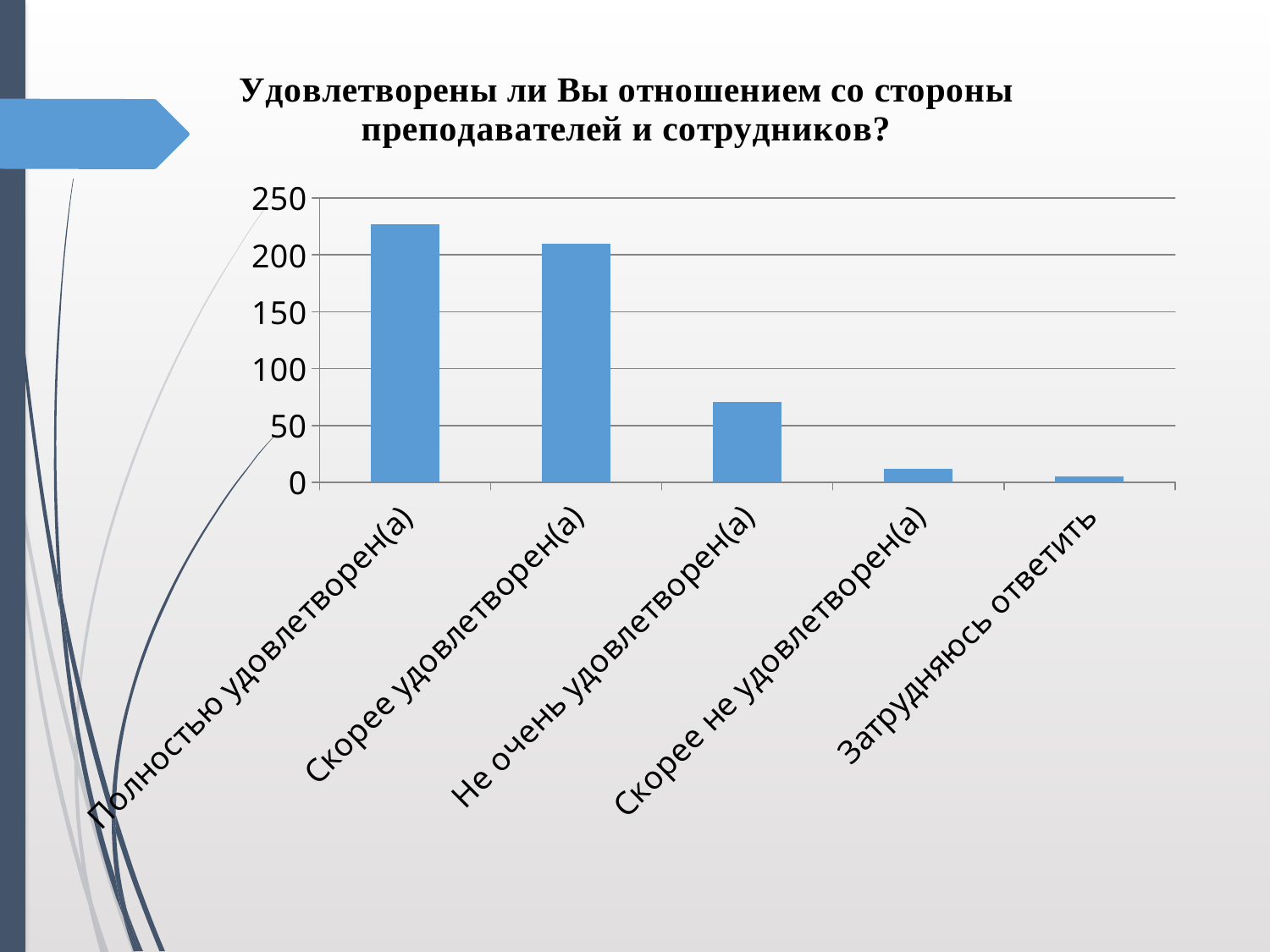
Which category has the lowest value? Затрудняюсь ответить Which category has the highest value? Полностью удовлетворен(а) Is the value for Не очень удовлетворен(а) greater or less than 100? less How many categories are shown on the x axis of the chart? 5 What kind of chart is shown on the slide? bar chart Do the values rise or fall moving from left to right along the x axis? fall Is the value for Полностью удовлетворен(а) greater or less than 200? greater What is the title of the chart? Удовлетворены ли Вы отношением со стороны преподавателей и сотрудников? Is the value for Скорее удовлетворен(а) greater or less than 250? less Which is larger, the value for Скорее удовлетворен(а) or the value for Не очень удовлетворен(а)? Скорее удовлетворен(а) Which is larger, the value for Скорее не удовлетворен(а) or the value for Затрудняюсь ответить? Скорее не удовлетворен(а)